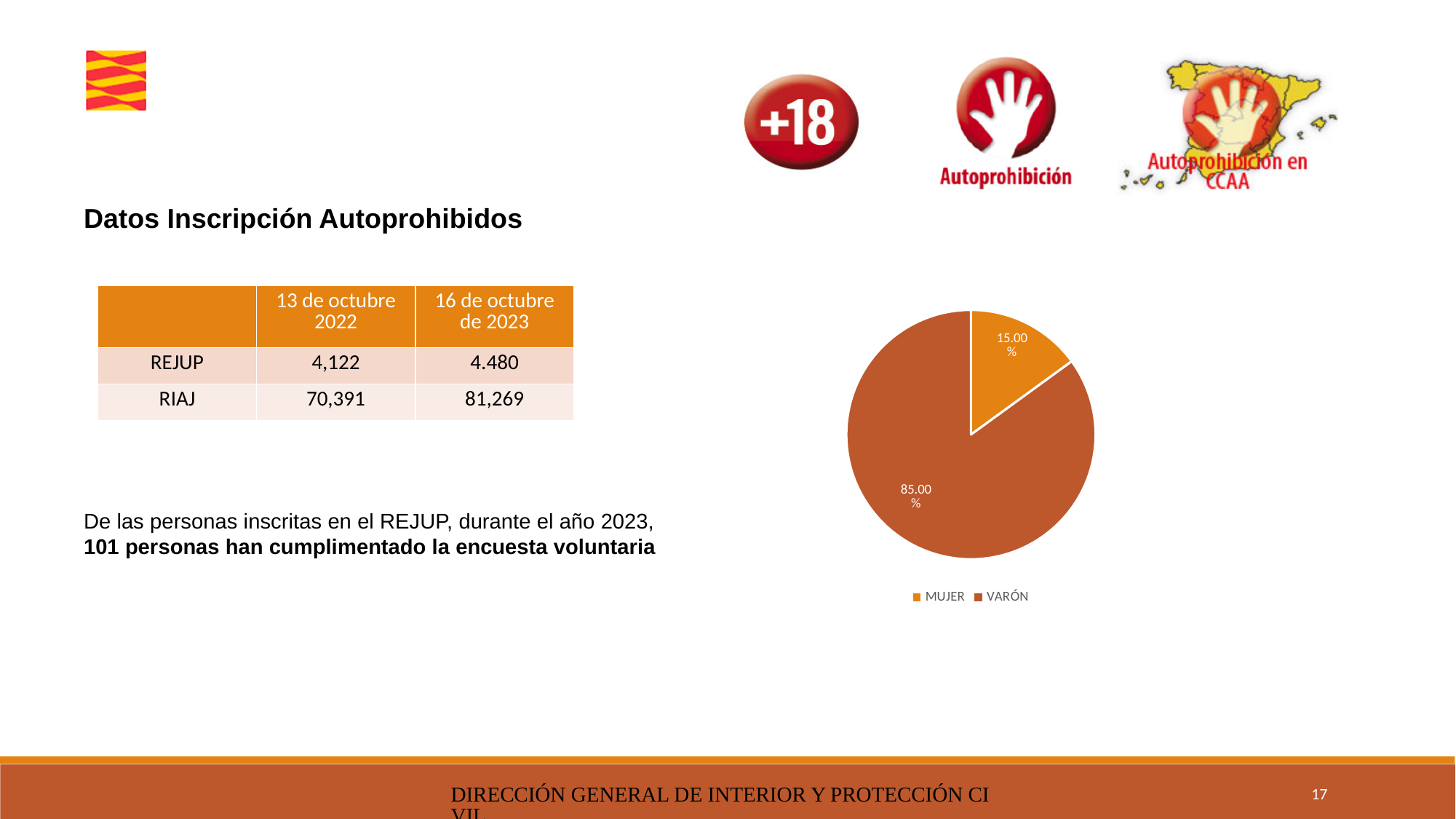
How many slices does the pie chart have? 2 Which category is shown in the lighter orange colour in the pie chart? MUJER How many entries does the pie chart legend list? 2 What is the difference in percentage points between the VARÓN and MUJER slices? 70.00% What kind of chart is shown on the slide? pie chart Which is larger in the pie chart, MUJER or VARÓN? VARÓN Which category has the smallest slice in the pie chart? MUJER What share of the pie chart does VARÓN represent? 85.00% What are the two categories listed in the pie chart legend? MUJER and VARÓN What share of the pie chart does MUJER represent? 15.00% Which category has the largest slice in the pie chart? VARÓN